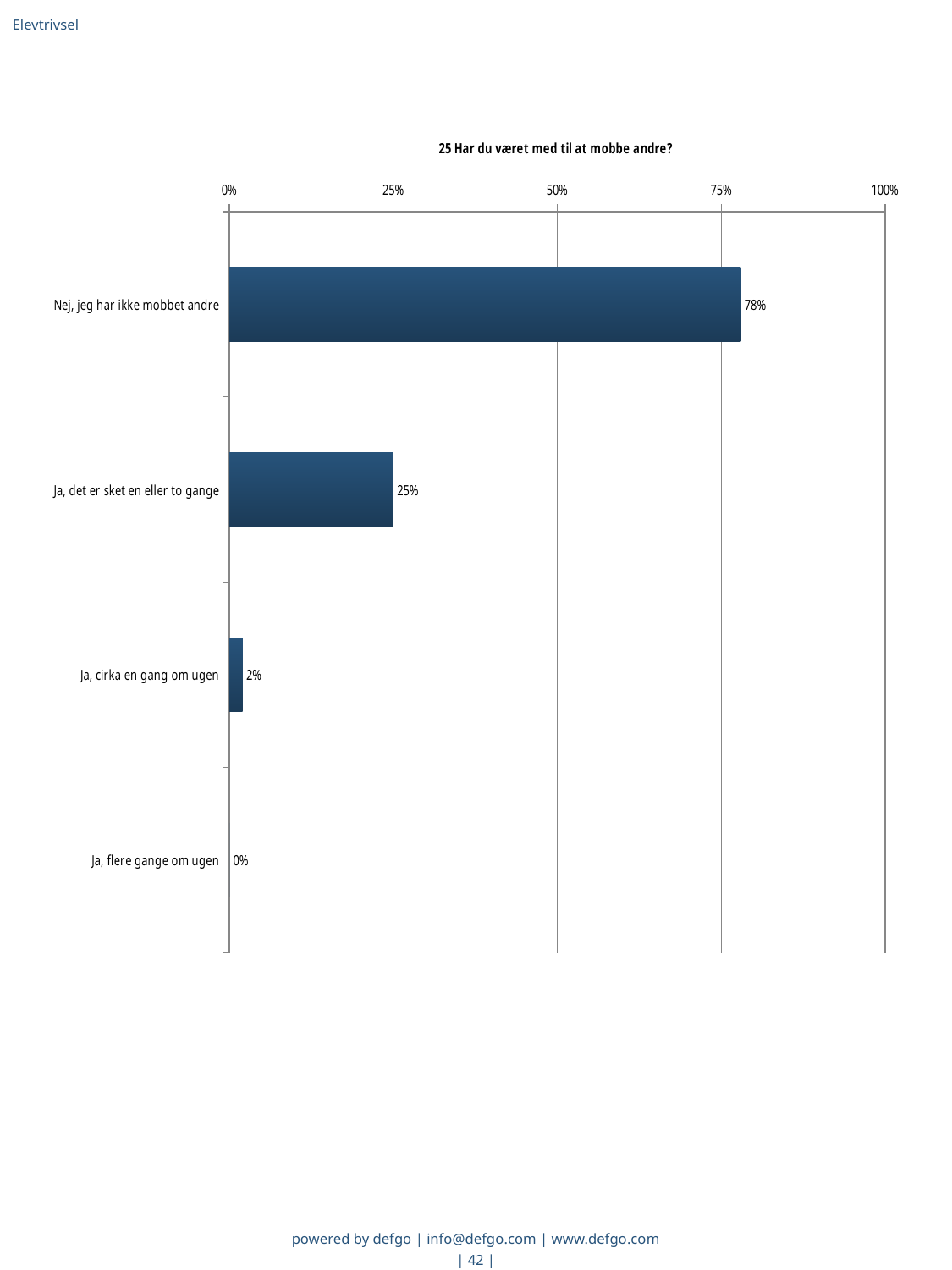
Which is larger: the value for "Ja, det er sket en eller to gange" or "Ja, cirka en gang om ugen"? Ja, det er sket en eller to gange What is the difference between the values for "Nej, jeg har ikke mobbet andre" and "Ja, det er sket en eller to gange"? 53% What is the value for "Ja, det er sket en eller to gange"? 25% Which category has the lowest value? Ja, flere gange om ugen Is the value for "Nej, jeg har ikke mobbet andre" greater or less than 75%? greater What is the title of the chart? 25 Har du været med til at mobbe andre? What is the value for "Nej, jeg har ikke mobbet andre"? 78% What is the value for "Ja, cirka en gang om ugen"? 2% How many categories are shown in the chart? 4 What is the value for "Ja, flere gange om ugen"? 0% What kind of chart is shown on the slide? bar chart Which category has the highest value? Nej, jeg har ikke mobbet andre